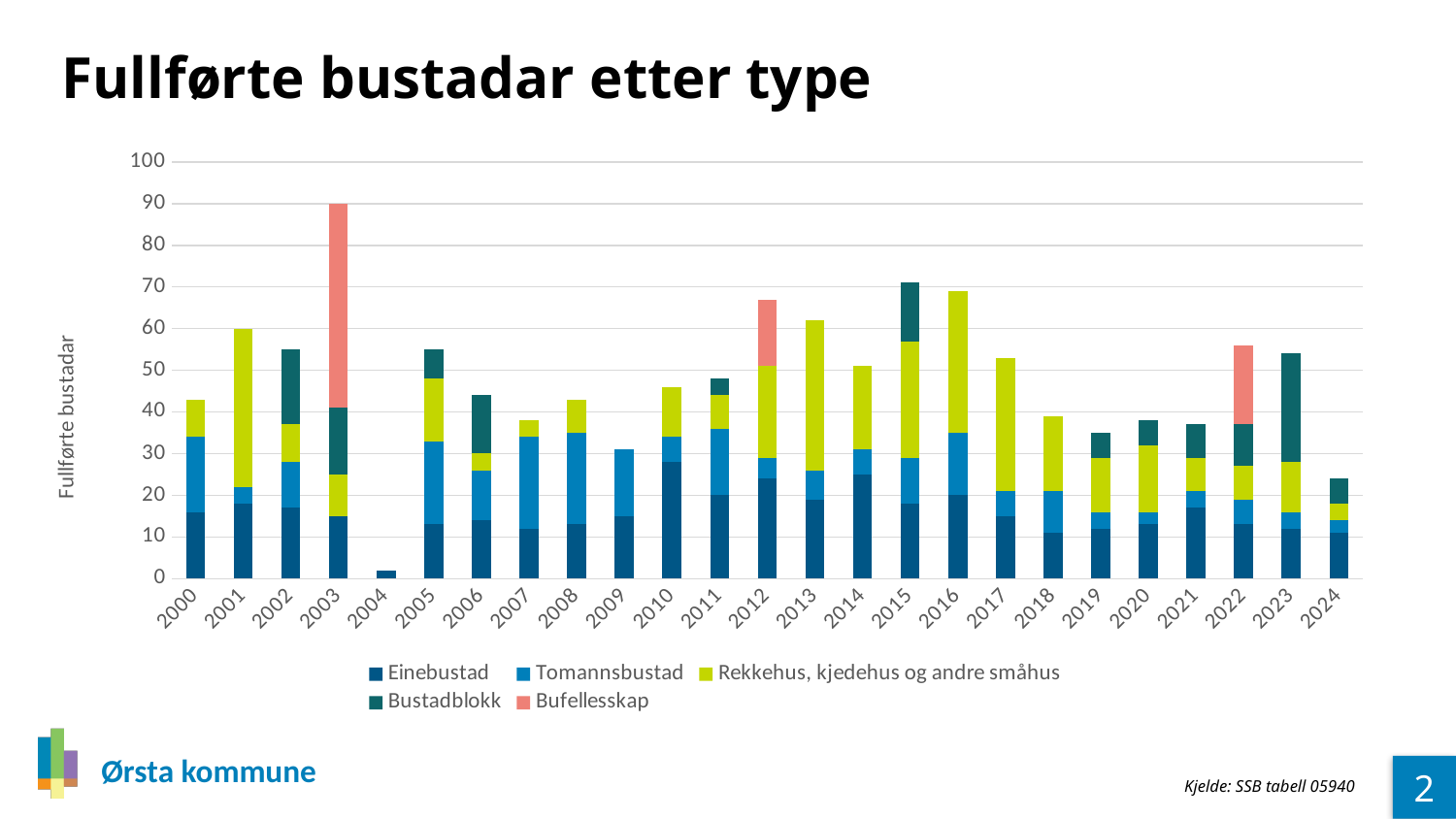
Which year has the lowest total of completed dwellings? 2004 What kind of chart is shown on the slide? Stacked bar chart Which year has a larger total, 2000 or 2001? 2001 Which year has the highest total of completed dwellings? 2003 Is the total for 2003 greater or less than 80? greater What is the title of the chart? Fullførte bustadar etter type How many series does the legend list? 5 Is the total for 2024 greater or less than 30? less How many years are shown along the x axis? 25 Which year has a larger total, 2013 or 2014? 2013 Is the total for 2004 greater or less than 10? less